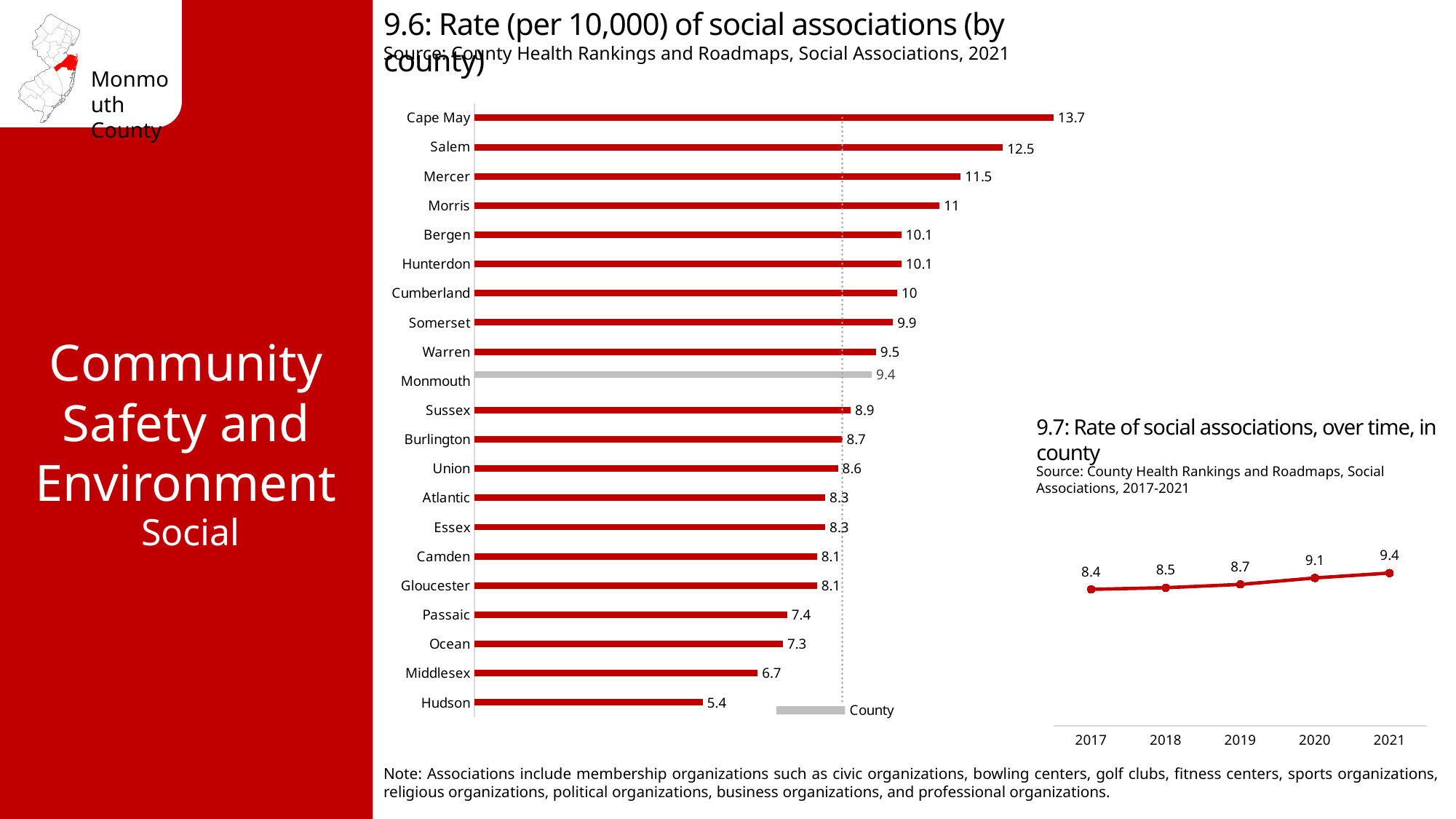
In the chart 9.6 (rate of social associations by county), which bar is shown in grey rather than red? Monmouth What kind of chart is chart 9.6 (rate of social associations by county)? Bar chart In the chart 9.6 (rate of social associations by county), what is the value for Monmouth? 9.4 In the chart 9.6 (rate of social associations by county), what is the difference between Cape May and Hudson? 8.3 In the chart 9.6 (rate of social associations by county), which is larger, the value for Salem or the value for Mercer? Salem In the chart 9.7 (rate of social associations over time), what is the value for 2019? 8.7 In the chart 9.7 (rate of social associations over time), do the values rise or fall from 2017 to 2021? Rise In the chart 9.6 (rate of social associations by county), which county has the highest rate? Cape May In the chart 9.6 (rate of social associations by county), which county has the lowest rate? Hudson In the chart 9.6 (rate of social associations by county), how many counties are plotted? 21 In the chart 9.6 (rate of social associations by county), what is the value for Cape May? 13.7 In the chart 9.7 (rate of social associations over time), what is the difference between the 2021 and 2017 values? 1